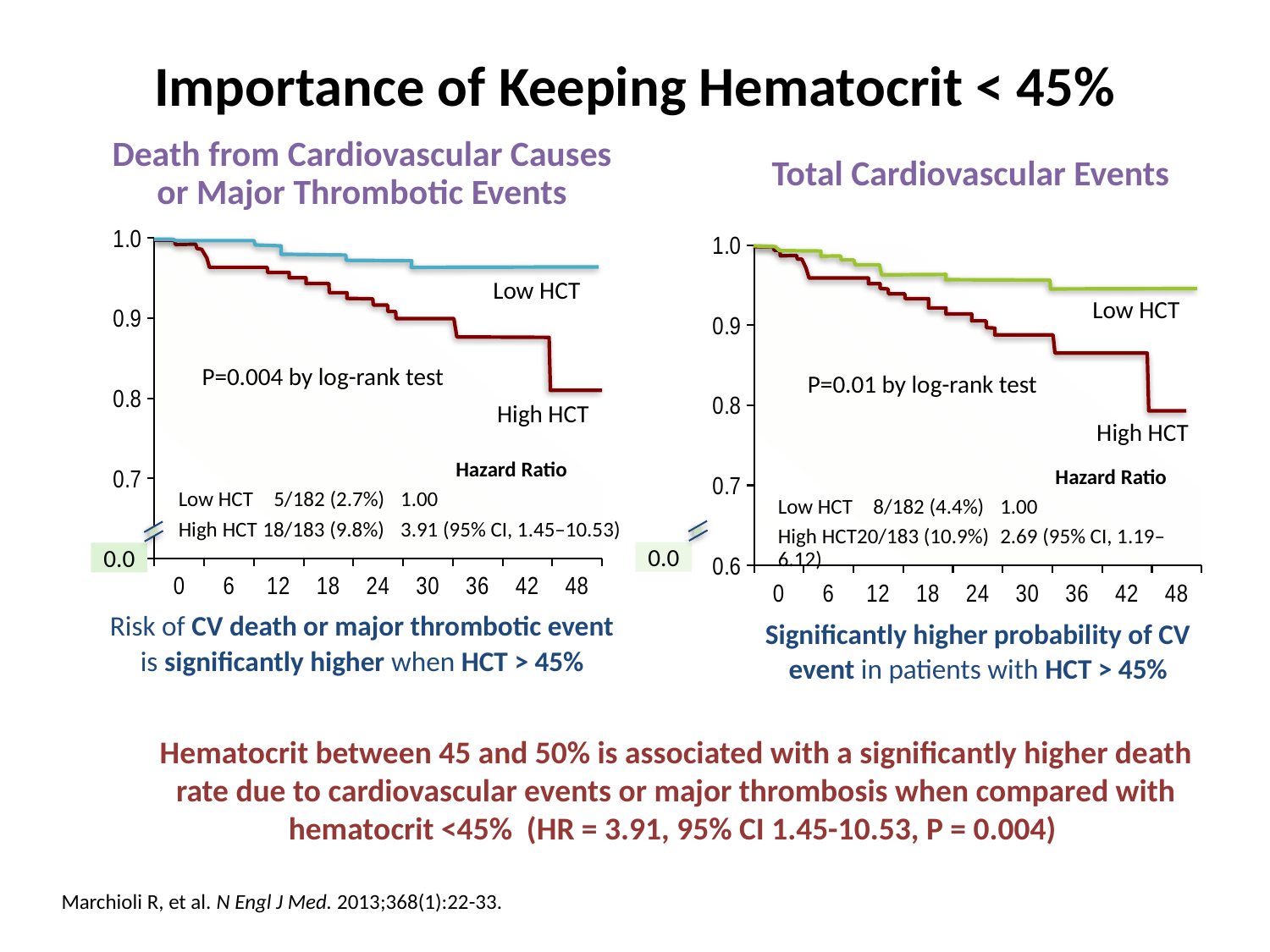
How many series are plotted in the right chart titled "Total Cardiovascular Events"? 2 In the left chart, do the survival curves rise or fall as time increases along the x axis? fall In the left chart, which group's curve is lower at 48 months, Low HCT or High HCT? High HCT What kind of chart is the left chart titled "Death from Cardiovascular Causes or Major Thrombotic Events"? Line chart What P value by log-rank test is shown on the right chart? P=0.01 In the left chart, how many events are listed for the Low HCT group? 5/182 (2.7%) In the left chart, is the Low HCT curve at 48 months greater or less than 0.9? greater In the right chart, is the High HCT curve at 48 months greater or less than 0.9? less What is the largest value shown on the x axis of the right chart? 48 What hazard ratio is printed for High HCT in the left chart? 3.91 (95% CI, 1.45–10.53) What colour is the Low HCT line in the right chart? Green What hazard ratio is printed for High HCT in the right chart? 2.69 (95% CI, 1.19–6.12)